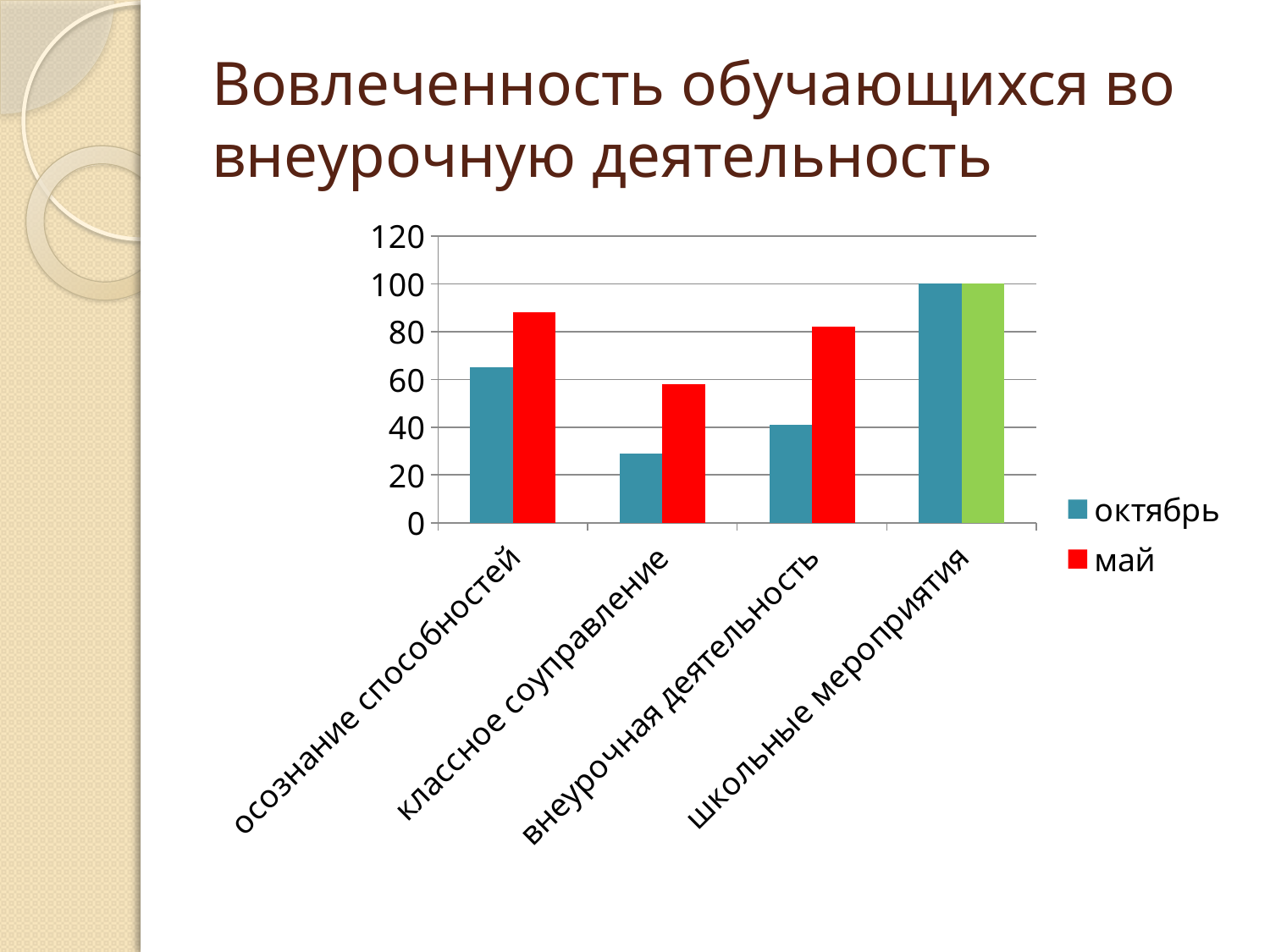
Which category has the lowest value for май? классное соуправление Is the value for октябрь in the category осознание способностей greater or less than 60? greater What is the value for май in the category школьные мероприятия? 100 Is the value for октябрь in the category классное соуправление greater or less than 40? less In the category классное соуправление, which is larger: the value for октябрь or the value for май? май Which series is shown in red in the legend? май What is the value for октябрь in the category школьные мероприятия? 100 What kind of chart is shown on the slide? bar chart Which category has the lowest value for октябрь? классное соуправление How many categories are shown on the x axis of the chart? 4 Which category has the highest value for октябрь? школьные мероприятия How many series does the chart's legend list? 2